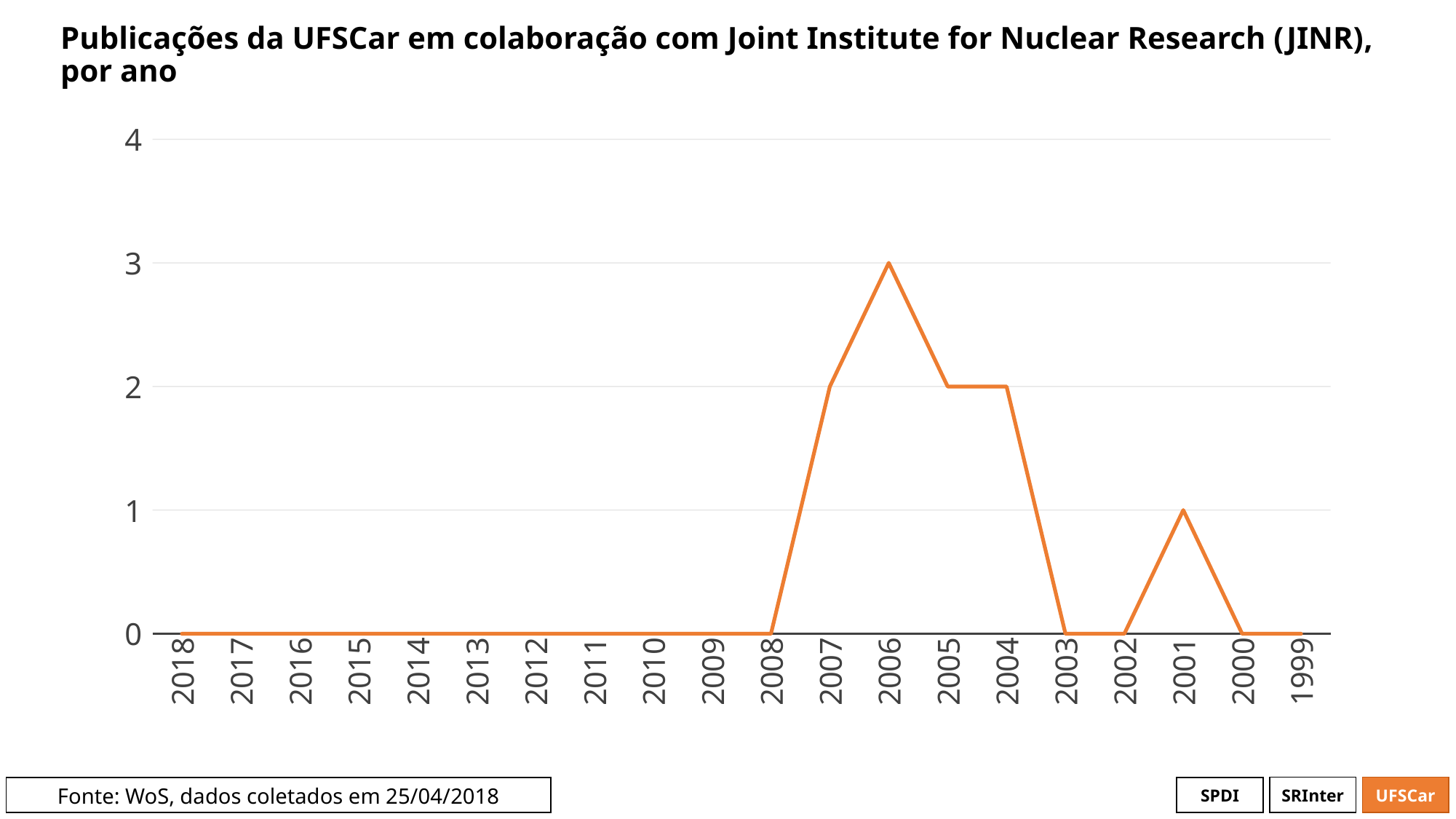
What is the source cited at the bottom of the slide? WoS, dados coletados em 25/04/2018 What is the value for 2012? 0 What is the value for 2003? 0 What is the value for 2006? 3 Does the value rise or fall from 2007 to 2006? rise Which is larger, the value for 2004 or the value for 2001? 2004 What is the value for 2007? 2 What type of chart is shown on the slide? line chart What is the difference between the values for 2006 and 2005? 1 Which year has the highest value? 2006 What is the value for 2001? 1 How many years are shown on the x axis? 20